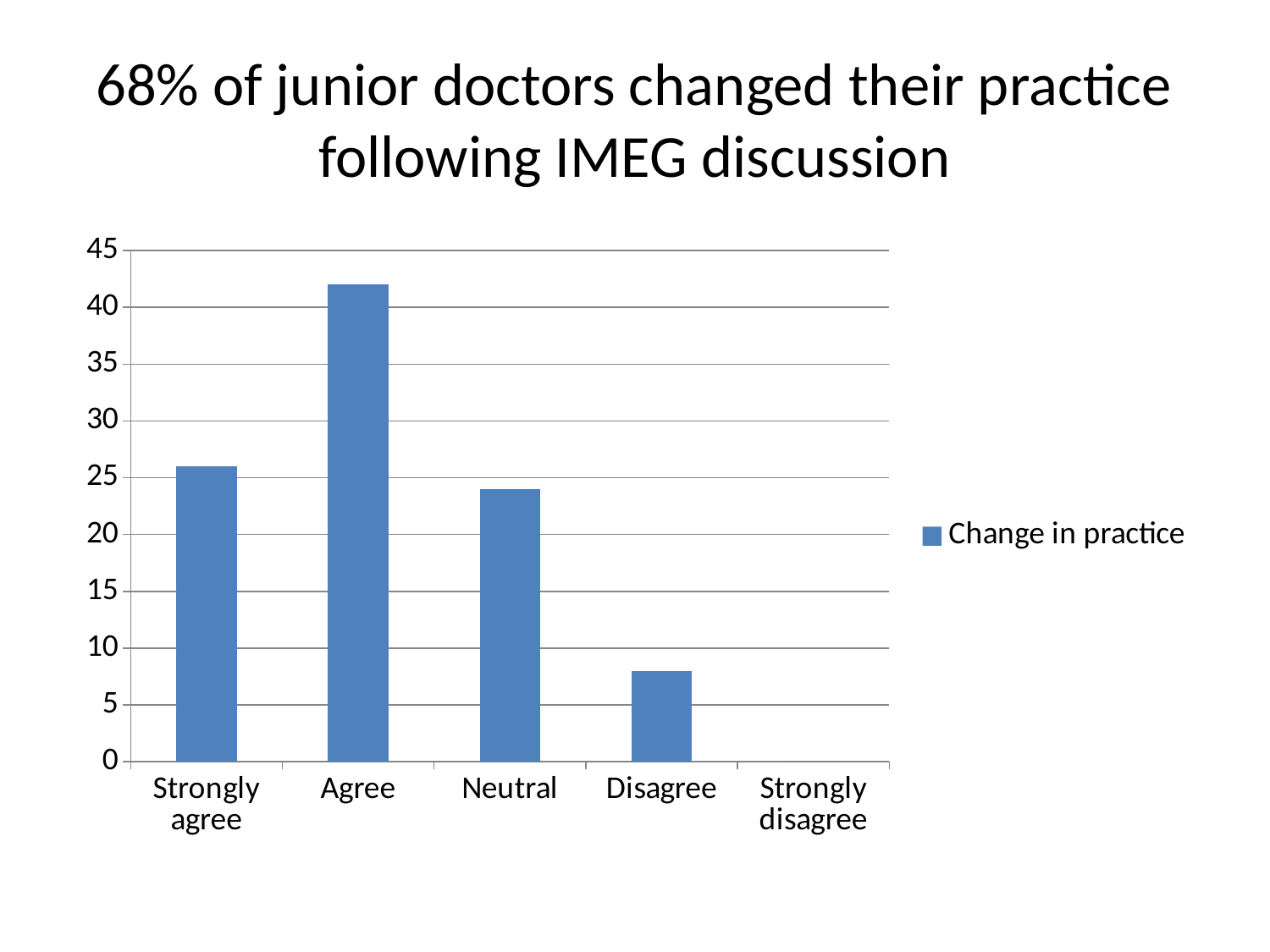
How many series does the legend list? 1 Which is larger, the value for Agree or the value for Neutral? Agree Which category has the lowest value? Strongly disagree How many categories are shown on the x axis? 5 What kind of chart is shown on the slide? bar chart What is the value for Strongly disagree? 0 Is the value for Agree greater or less than 35? greater Which is larger, the value for Strongly agree or the value for Disagree? Strongly agree Is the value for Strongly agree greater or less than 20? greater Which category has the highest value? Agree Is the value for Disagree greater or less than 10? less What is the name of the series shown in the legend? Change in practice